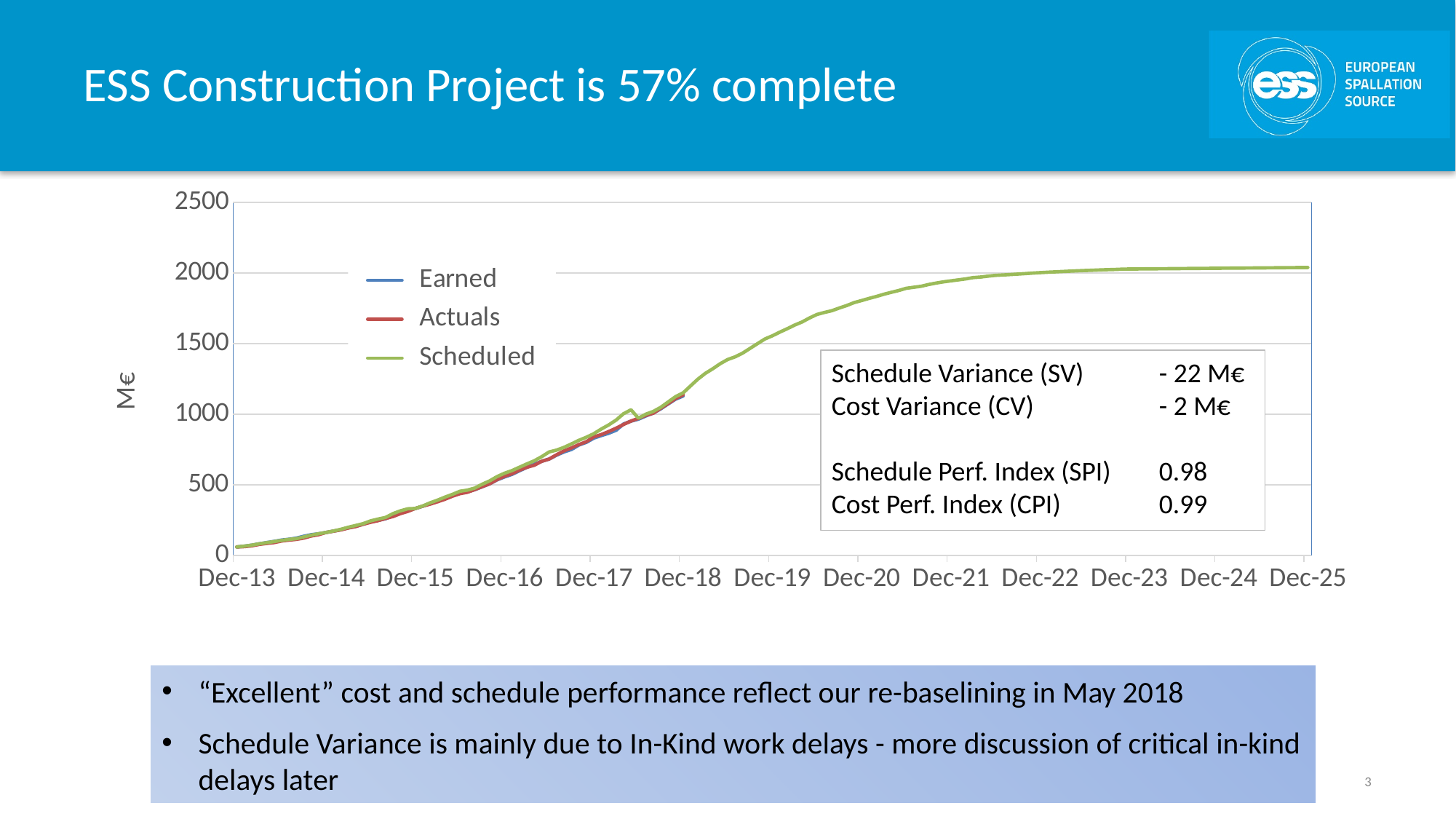
Which is larger for the Scheduled series: the value at Dec-21 or the value at Dec-17? Dec-21 Is the Scheduled value at Dec-15 greater or less than 500? less Does the Scheduled line rise or fall from Dec-13 to Dec-25? rise Is the Scheduled value at Dec-19 greater or less than 1000? greater How many date labels are shown along the x-axis of the chart? 13 Is the Scheduled value at Dec-21 greater or less than 1500? greater How many series does the chart legend list? 3 Which series are listed in the chart legend? Earned, Actuals, Scheduled What kind of chart is shown on the slide? line chart What unit is shown on the y-axis of the chart? M€ What Schedule Variance (SV) is shown in the box on the chart? - 22 M€